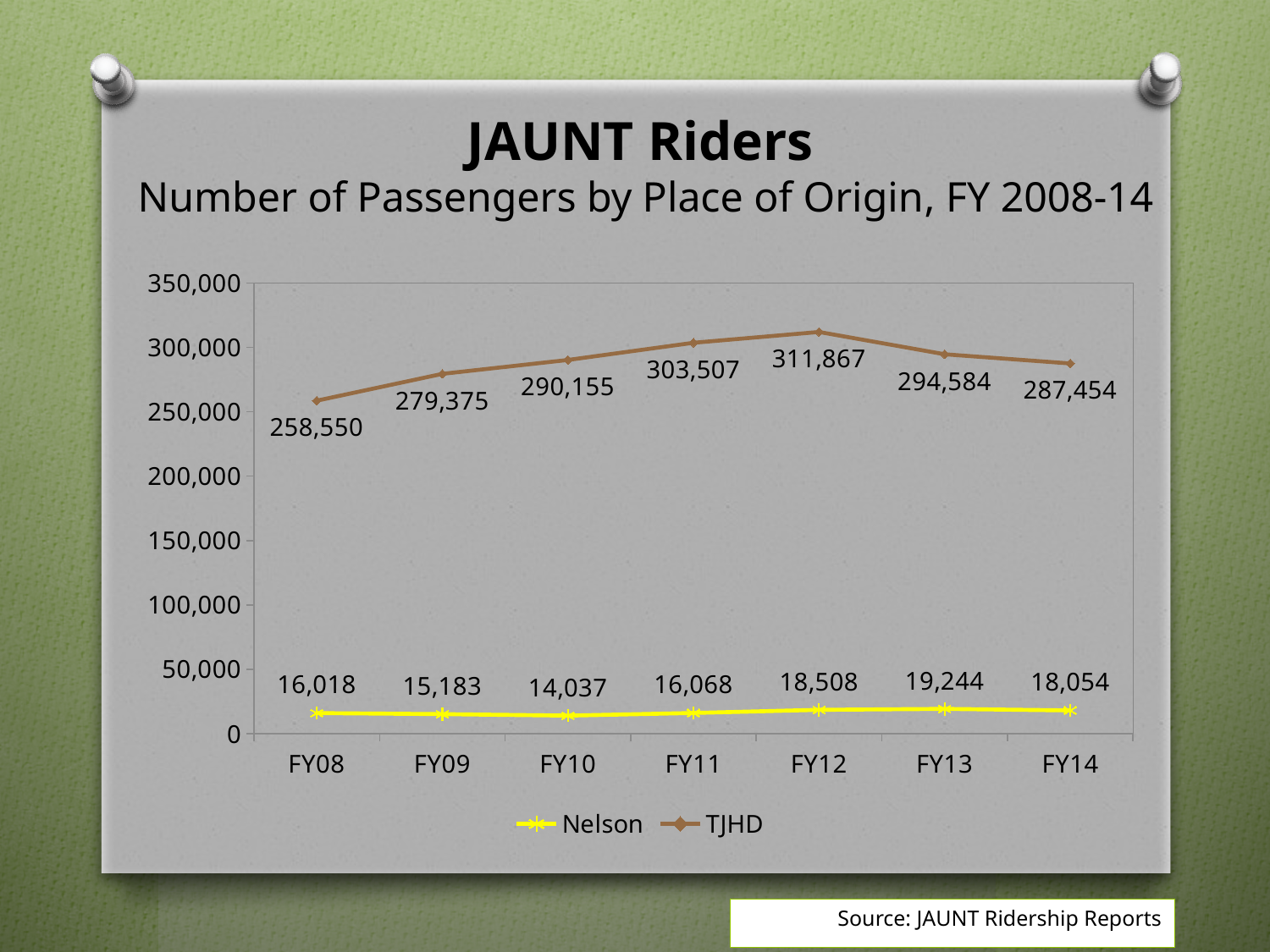
What is the Nelson value for FY10? 14,037 What is the TJHD value for FY08? 258,550 In which fiscal year is the TJHD value lowest? FY08 What is the TJHD value for FY12? 311,867 Is the TJHD value for FY11 greater or less than 300,000? greater What kind of chart is shown on the slide? line chart What is the difference between the TJHD values for FY12 and FY14? 24,413 How many series does the legend list? 2 In which fiscal year is the Nelson value highest? FY13 How many fiscal years are shown on the x axis? 7 Does the TJHD series rise or fall from FY08 to FY12? rise Which is larger, the Nelson value for FY09 or for FY11? FY11